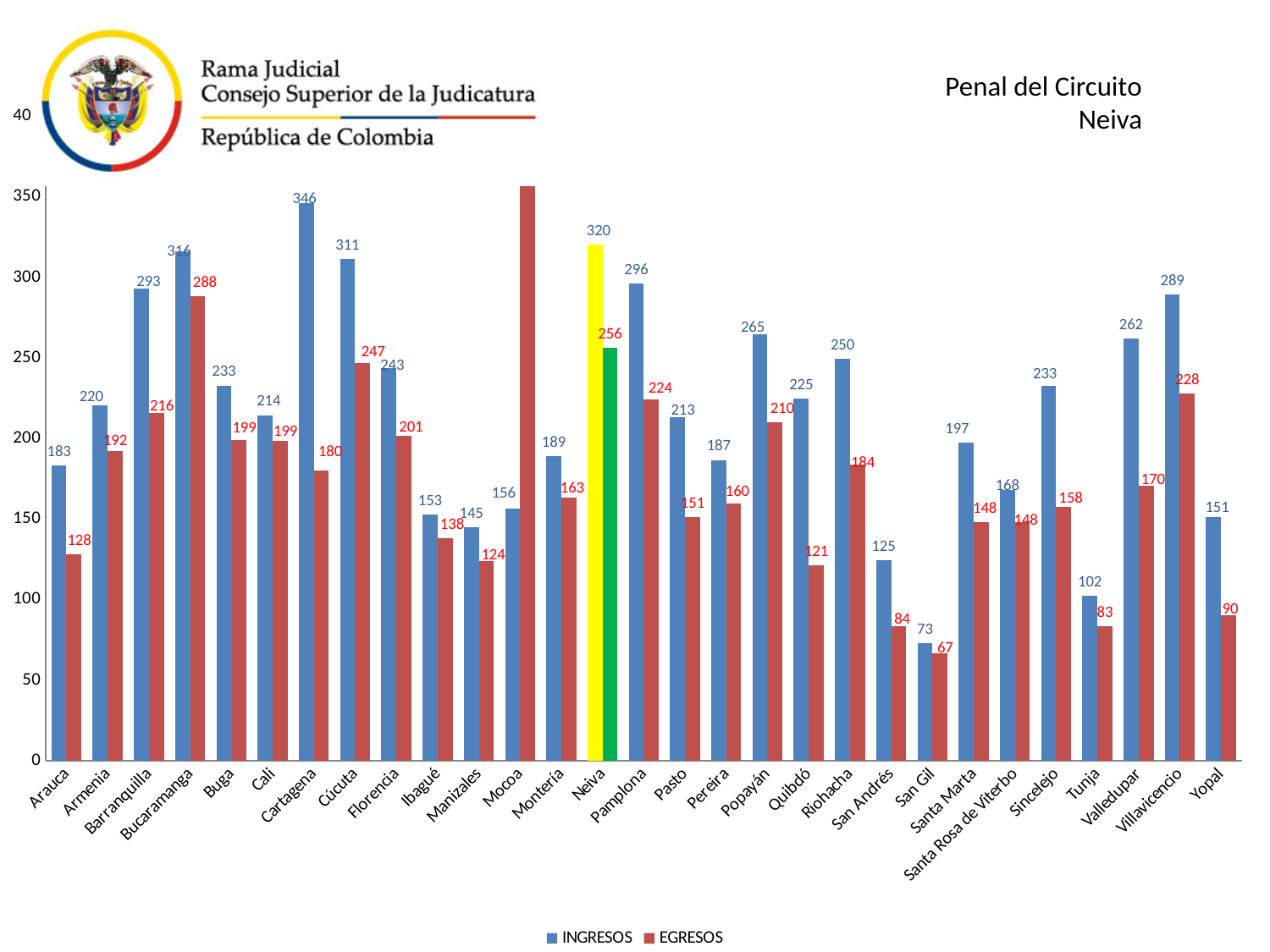
Which city has the highest INGRESOS value? Cartagena Is the EGRESOS value for Mocoa greater or less than 350? greater Which is larger, the INGRESOS value for Bucaramanga or the INGRESOS value for Neiva? Neiva Which city's bars are highlighted in yellow and green? Neiva What is the EGRESOS value for Yopal? 90 What is the INGRESOS value for Neiva? 320 What is the difference between INGRESOS and EGRESOS for Cartagena? 166 Which city has the lowest EGRESOS value? San Gil What kind of chart is shown on the slide? bar chart How many cities are shown on the x axis? 29 What is the EGRESOS value for Cúcuta? 247 How many series does the legend list? 2